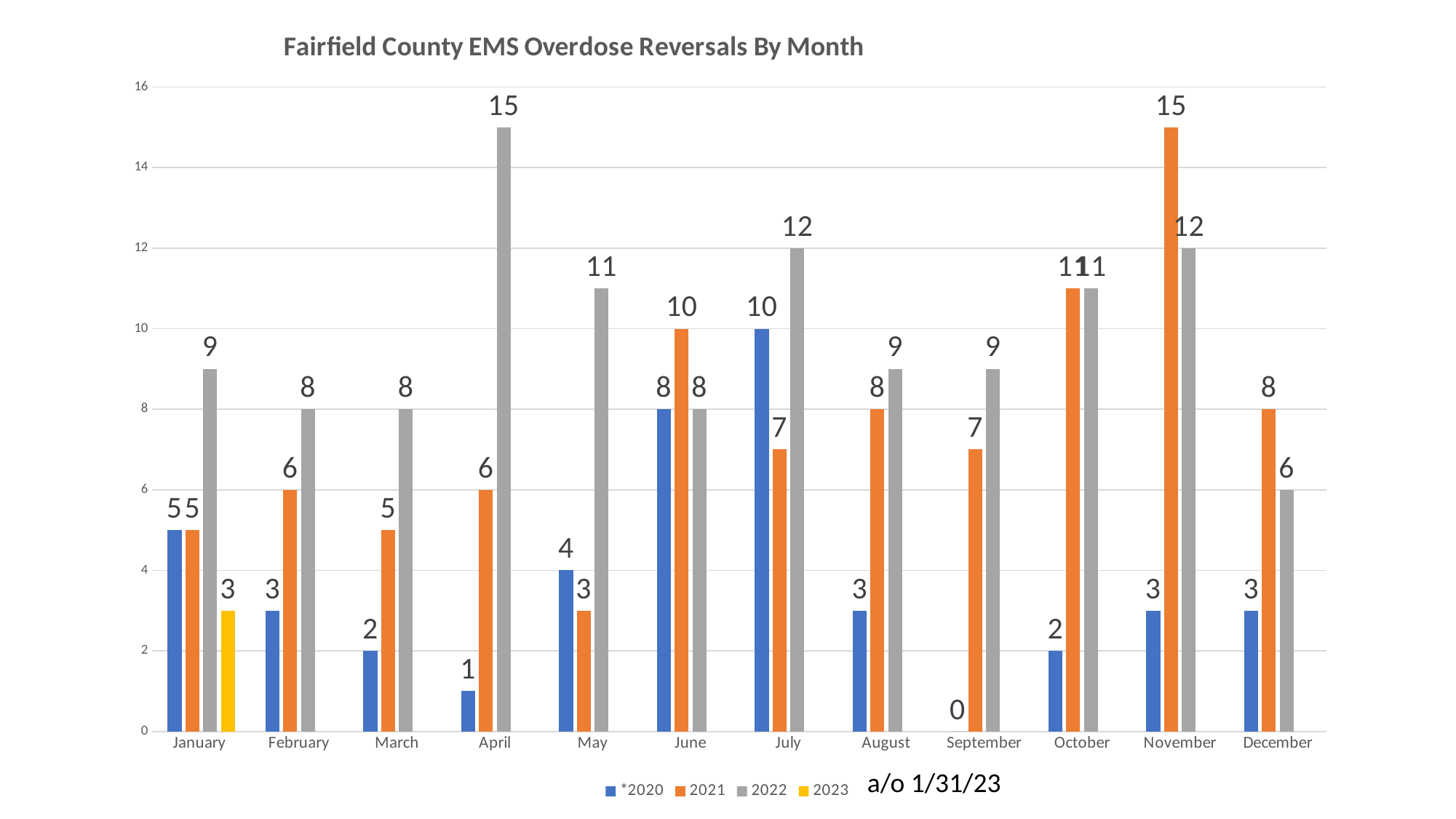
What is the value for 2022 in April? 15 What is the difference between the 2021 and 2022 values in December? 2 What is the value for 2023 in January? 3 In which month is the 2022 value highest? April What is the difference between the 2022 and 2020 values in April? 14 What is the value for 2021 in November? 15 Which is larger in July, the 2020 value or the 2021 value? 2020 What is the title of the chart? Fairfield County EMS Overdose Reversals By Month How many months are shown on the x axis? 12 In which month is the 2020 value lowest? September How many series does the legend list? 4 What kind of chart is shown on the slide? Bar chart